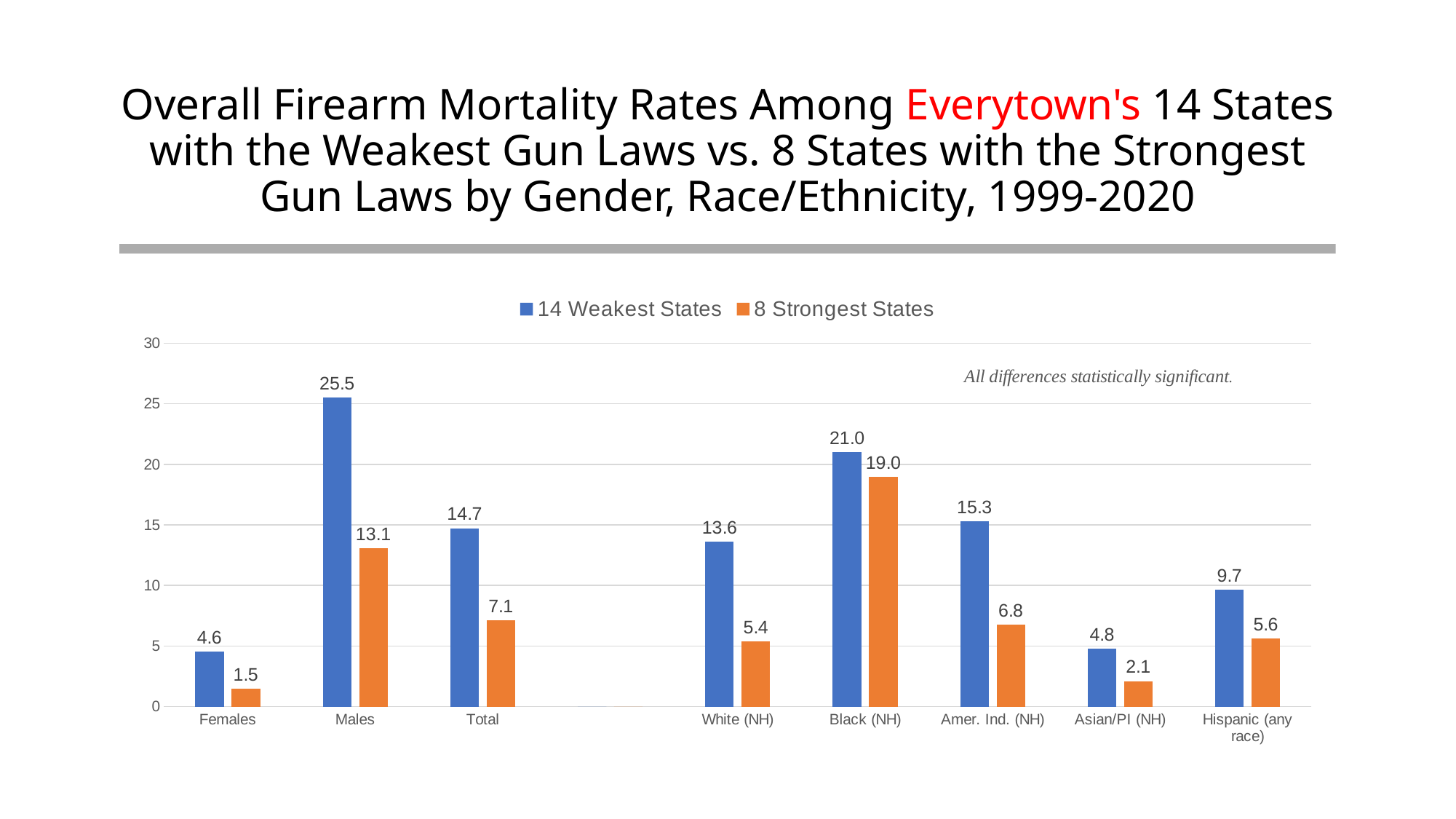
Which is larger: the 14 Weakest States value for Amer. Ind. (NH) or the 14 Weakest States value for White (NH)? Amer. Ind. (NH) What is the value for Males in the 14 Weakest States series? 25.5 What is the difference between the 14 Weakest States and 8 Strongest States values for Black (NH)? 2.0 How many series does the legend list? 2 What kind of chart is shown on the slide? Bar chart Which colour represents the 8 Strongest States series? Orange Is the 14 Weakest States value for Hispanic (any race) greater or less than 10? less What is the value for Total in the 8 Strongest States series? 7.1 What is the value for Black (NH) in the 8 Strongest States series? 19.0 Which category has the lowest value in the 8 Strongest States series? Females What is the difference between the 14 Weakest States and 8 Strongest States values for Males? 12.4 Which category has the highest value in the 14 Weakest States series? Males